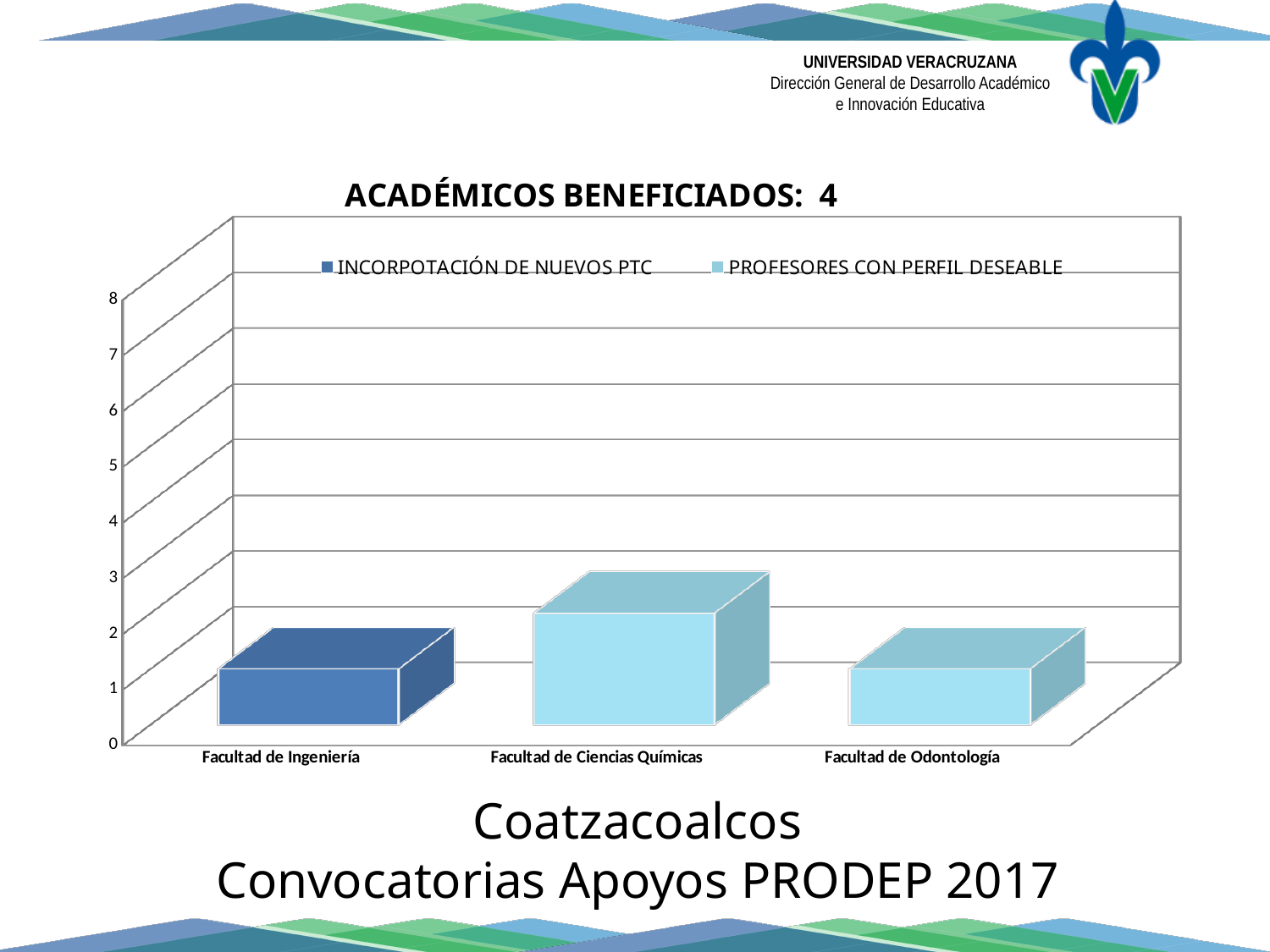
Which faculty has the highest bar in the chart? Facultad de Ciencias Químicas What kind of chart is shown on the slide? bar chart Which is larger, the bar for Facultad de Ciencias Químicas or the bar for Facultad de Ingeniería? Facultad de Ciencias Químicas Is the value for Facultad de Ingeniería greater or less than 2? less Is the value for Facultad de Ciencias Químicas greater or less than 3? less How many faculties (categories) are shown on the x axis of the chart? 3 Which legend series does the bar for Facultad de Ingeniería belong to? INCORPOTACIÓN DE NUEVOS PTC Is the value for Facultad de Odontología greater or less than 2? less How many series does the chart legend list? 2 Which is larger, the bar for Facultad de Ciencias Químicas or the bar for Facultad de Odontología? Facultad de Ciencias Químicas What is the title of the chart? ACADÉMICOS BENEFICIADOS: 4